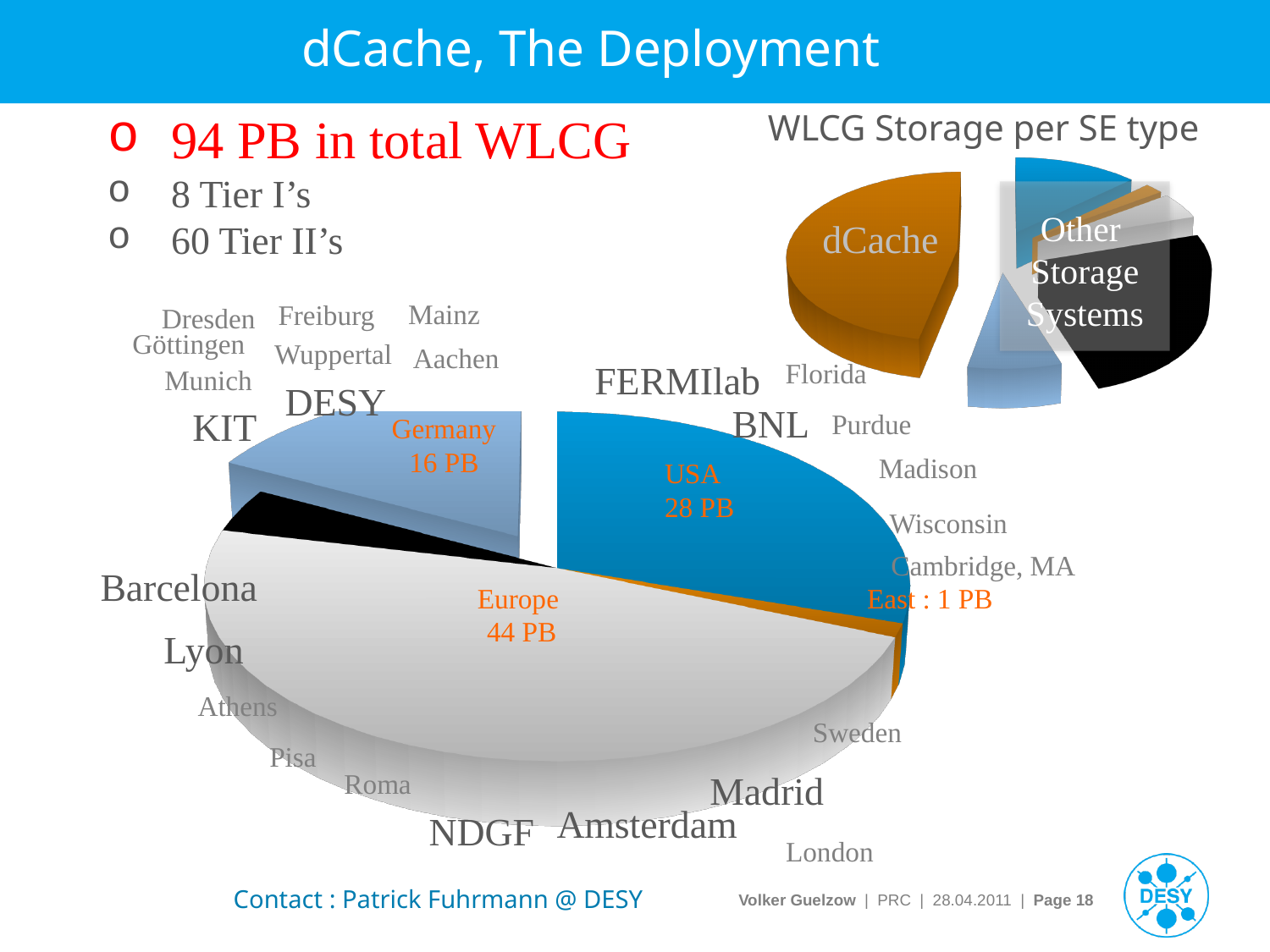
In the large pie chart, what value is shown for USA? 28 PB In the large pie chart, which region has the largest value? Europe In the large pie chart, what value is shown for East? 1 PB In the large pie chart, how many regions have a value labelled? 4 In the large pie chart, which is larger, the value for USA or the value for Germany? USA In the large pie chart, what value is shown for Europe? 44 PB In the large pie chart, what is the difference between the Europe and USA values? 16 PB In the large pie chart, what is the difference between the USA and Germany values? 12 PB In the large pie chart, what value is shown for Germany? 16 PB What is the title of the small pie chart in the upper right of the slide? WLCG Storage per SE type What kind of chart is the large chart in the lower part of the slide? pie chart In the large pie chart, which region has the smallest value? East